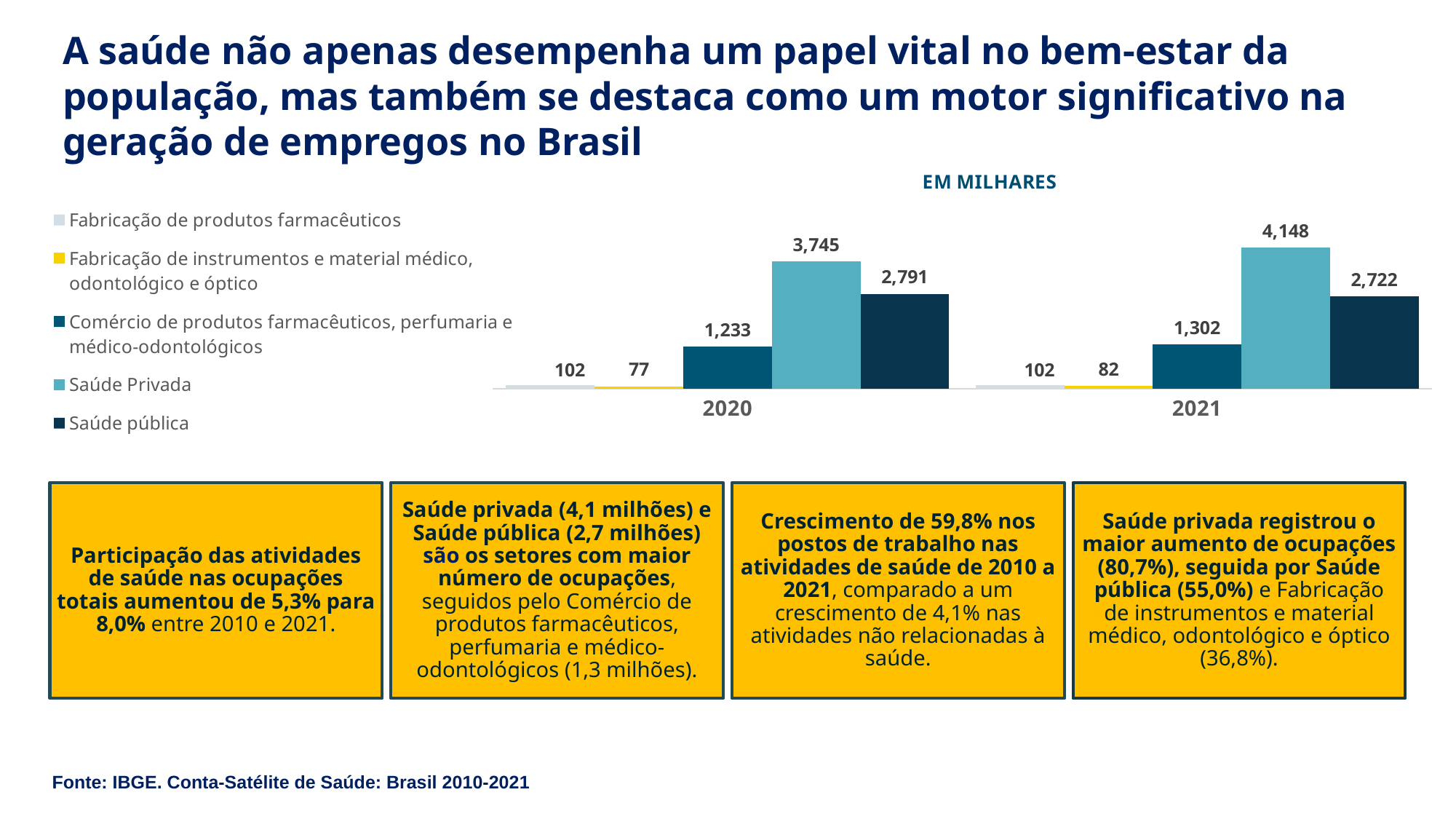
What unit label is shown above the chart? EM MILHARES What is the difference between the Saúde Privada values for 2021 and 2020? 403 How many series does the legend list? 5 What is the value for Saúde pública in 2020? 2,791 Which series has the lowest value in 2021? Fabricação de instrumentos e material médico, odontológico e óptico What kind of chart is shown on the slide? Bar chart What is the value for Saúde Privada in 2021? 4,148 Which series has the highest value in 2020? Saúde Privada How many year categories are shown on the x axis? 2 What is the value for Comércio de produtos farmacêuticos, perfumaria e médico-odontológicos in 2021? 1,302 Which is larger: Saúde pública in 2020 or Saúde pública in 2021? Saúde pública in 2020 What is the value for Fabricação de instrumentos e material médico, odontológico e óptico in 2020? 77